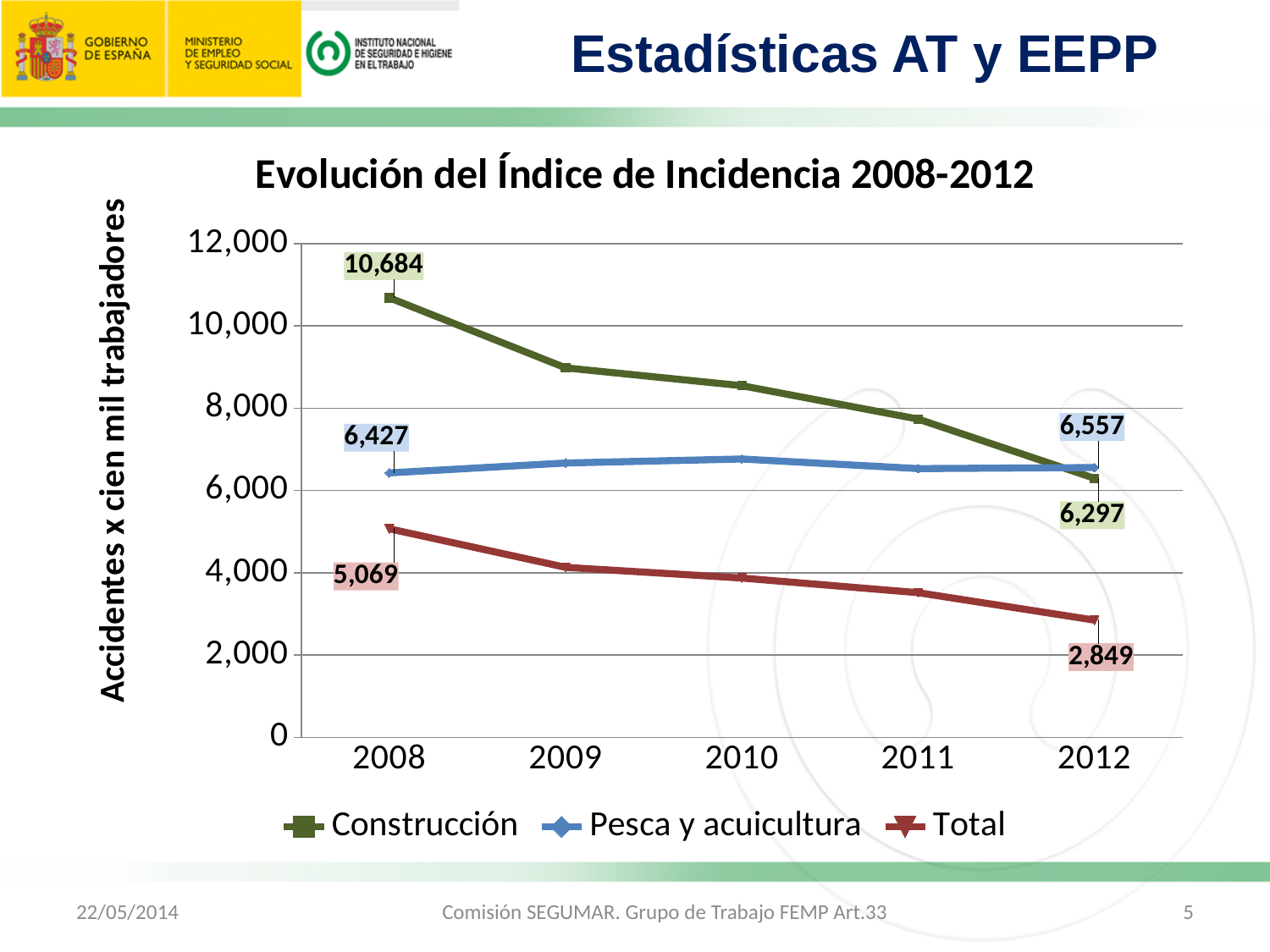
What is the value for Total in 2012? 2,849 By how much did the Construcción value fall from 2008 to 2012? 4,387 In 2012, which is larger: Pesca y acuicultura or Construcción? Pesca y acuicultura Is the value for Construcción in 2010 greater or less than 8,000? greater What is the difference between the Pesca y acuicultura values in 2012 and 2008? 130 What is the value for Construcción in 2008? 10,684 Does the Construcción series rise or fall from 2008 to 2012? fall Which series has the highest value in 2008? Construcción Which series has the lowest value in 2012? Total What is the value for Total in 2008? 5,069 How many series does the legend list? 3 What is the value for Pesca y acuicultura in 2012? 6,557